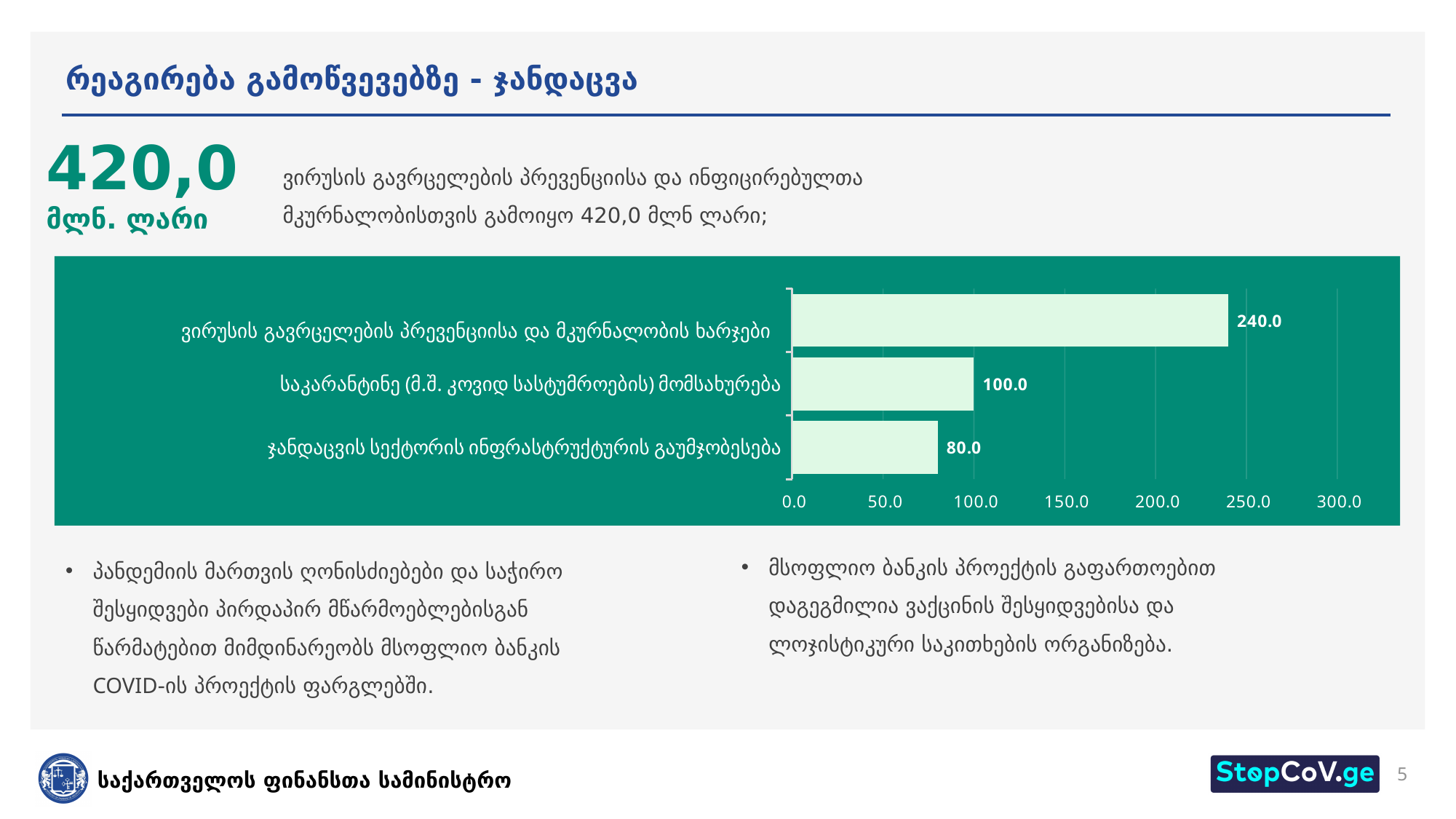
What is the value for ჯანდაცვის სექტორის ინფრასტრუქტურის გაუმჯობესება? 80.0 Which category has the highest value? ვირუსის გავრცელების პრევენციისა და მკურნალობის ხარჯები Which category has the lowest value? ჯანდაცვის სექტორის ინფრასტრუქტურის გაუმჯობესება What is the sum of the three values shown in the chart? 420.0 What is the difference between the values for ვირუსის გავრცელების პრევენციისა და მკურნალობის ხარჯები and საკარანტინე (მ.შ. კოვიდ სასტუმროების) მომსახურება? 140.0 How many categories are shown in the chart? 3 What kind of chart is shown on the slide? bar chart Which is larger: the value for საკარანტინე (მ.შ. კოვიდ სასტუმროების) მომსახურება or the value for ჯანდაცვის სექტორის ინფრასტრუქტურის გაუმჯობესება? საკარანტინე (მ.შ. კოვიდ სასტუმროების) მომსახურება Is the value for ვირუსის გავრცელების პრევენციისა და მკურნალობის ხარჯები greater or less than 200.0? greater What is the difference between the values for საკარანტინე (მ.შ. კოვიდ სასტუმროების) მომსახურება and ჯანდაცვის სექტორის ინფრასტრუქტურის გაუმჯობესება? 20.0 What is the value for საკარანტინე (მ.შ. კოვიდ სასტუმროების) მომსახურება? 100.0 What is the value for ვირუსის გავრცელების პრევენციისა და მკურნალობის ხარჯები? 240.0